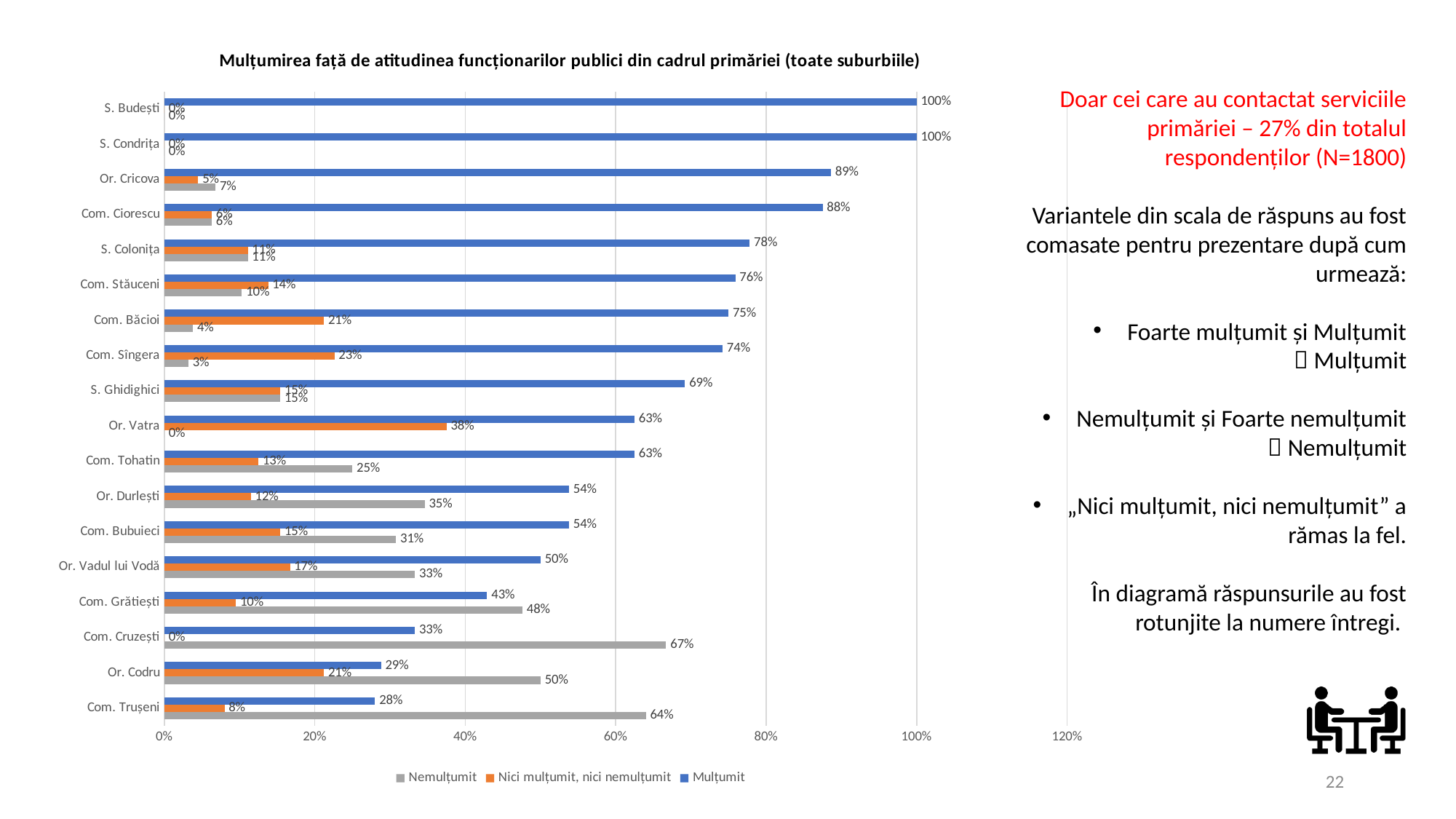
What kind of chart is shown on the slide? bar chart What is the 'Nici mulțumit, nici nemulțumit' value for Or. Vatra? 38% How many localities (categories) are shown on the chart? 18 What is the Nemulțumit value for Com. Cruzești? 67% Which colour represents the Mulțumit series in the legend? blue What is the Mulțumit value for Com. Grătiești? 43% Which locality has the highest 'Nici mulțumit, nici nemulțumit' value? Or. Vatra What is the Mulțumit value for Or. Cricova? 89% For Or. Codru, which is larger: the Nemulțumit value or the Mulțumit value? Nemulțumit How many series does the legend list? 3 For Com. Trușeni, what is the difference between the Nemulțumit value and the Mulțumit value? 36% Which locality has the highest Nemulțumit value? Com. Cruzești